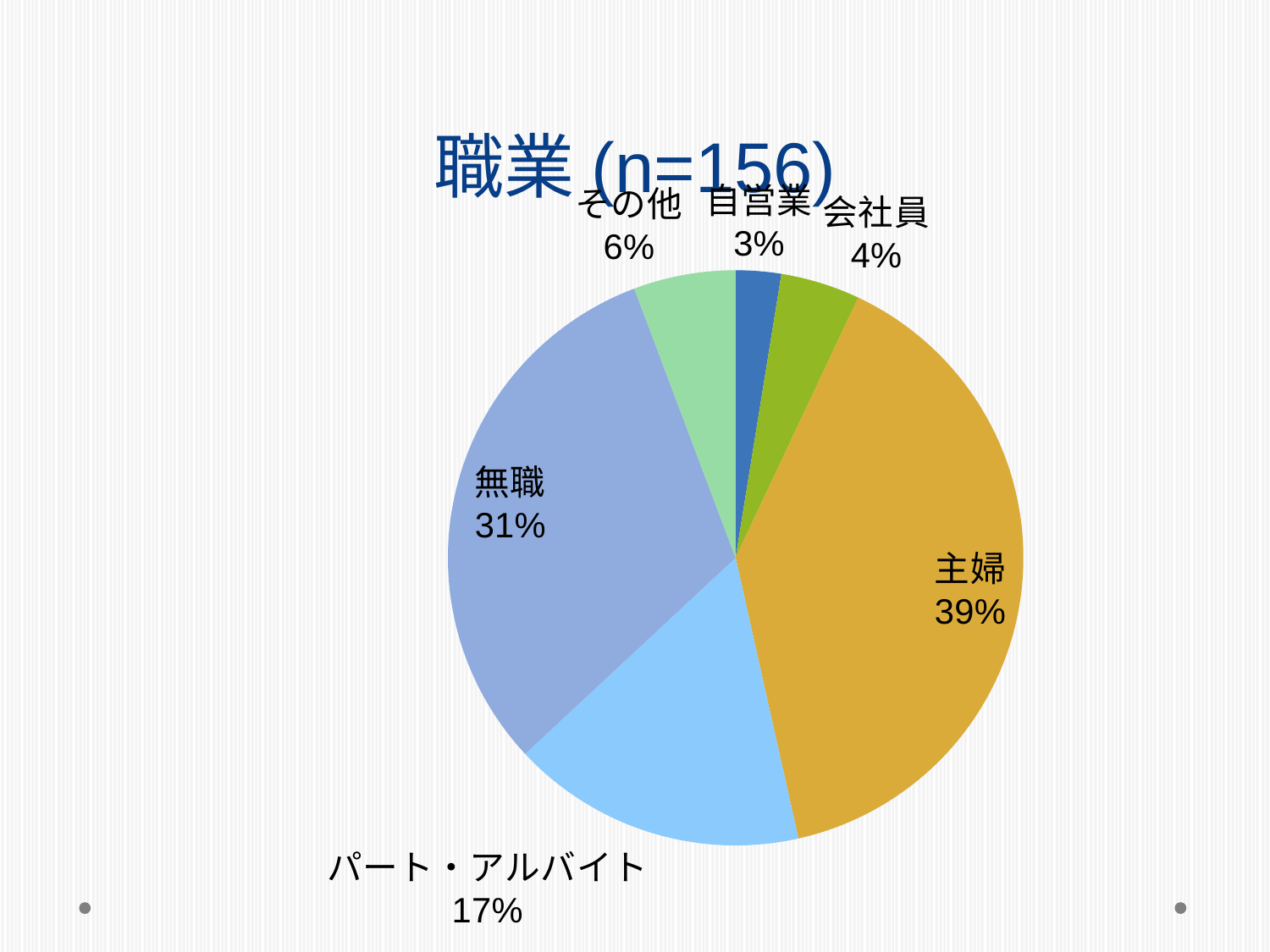
What is the value for パート・アルバイト? 17% Which category has the smallest slice? 自営業 What share of the pie does 主婦 have? 39% What is the value for その他? 6% What is the title of the chart? 職業 (n=156) What is the difference between the shares of 主婦 and 無職? 8% What share of the pie does 無職 have? 31% Which category has the largest slice? 主婦 Which is larger, the share for 会社員 or the share for その他? その他 What is the value for 自営業? 3% How many categories are shown in the pie chart? 6 What kind of chart is shown on the slide? pie chart